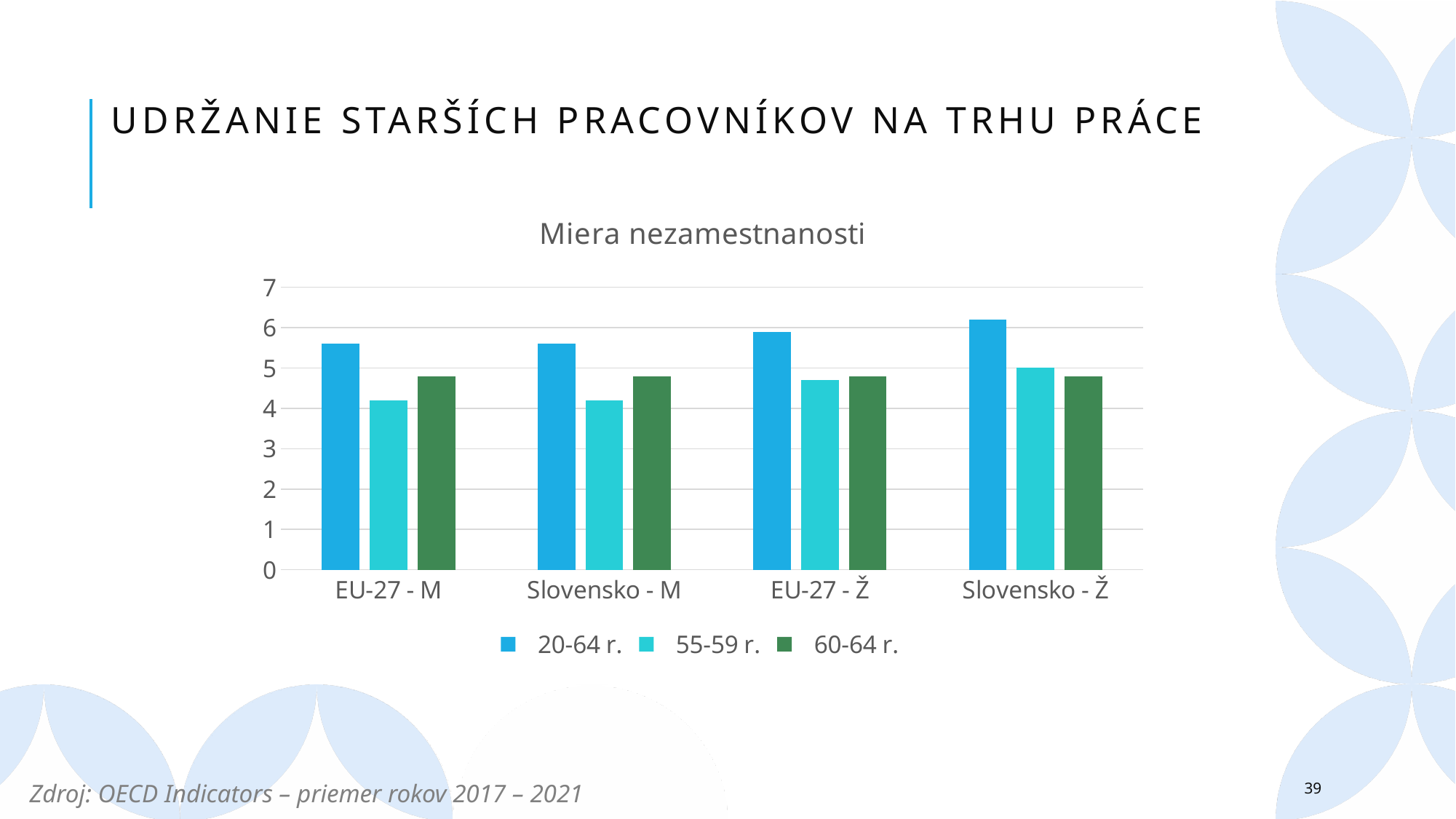
Which category has the highest 20-64 r. value? Slovensko - Ž Is the value for 20-64 r. in EU-27 - Ž greater or less than 5? greater Is the value for 60-64 r. in Slovensko - M greater or less than 4? greater What is the title of the chart? Miera nezamestnanosti In EU-27 - M, which series has the lowest value? 55-59 r. Is the value for 20-64 r. in Slovensko - Ž greater or less than 5? greater In Slovensko - Ž, which is larger: the 20-64 r. value or the 55-59 r. value? 20-64 r. Which series are listed in the legend? 20-64 r., 55-59 r., 60-64 r. How many series does the legend list? 3 What kind of chart is shown on the slide? bar chart How many categories are shown on the x axis? 4